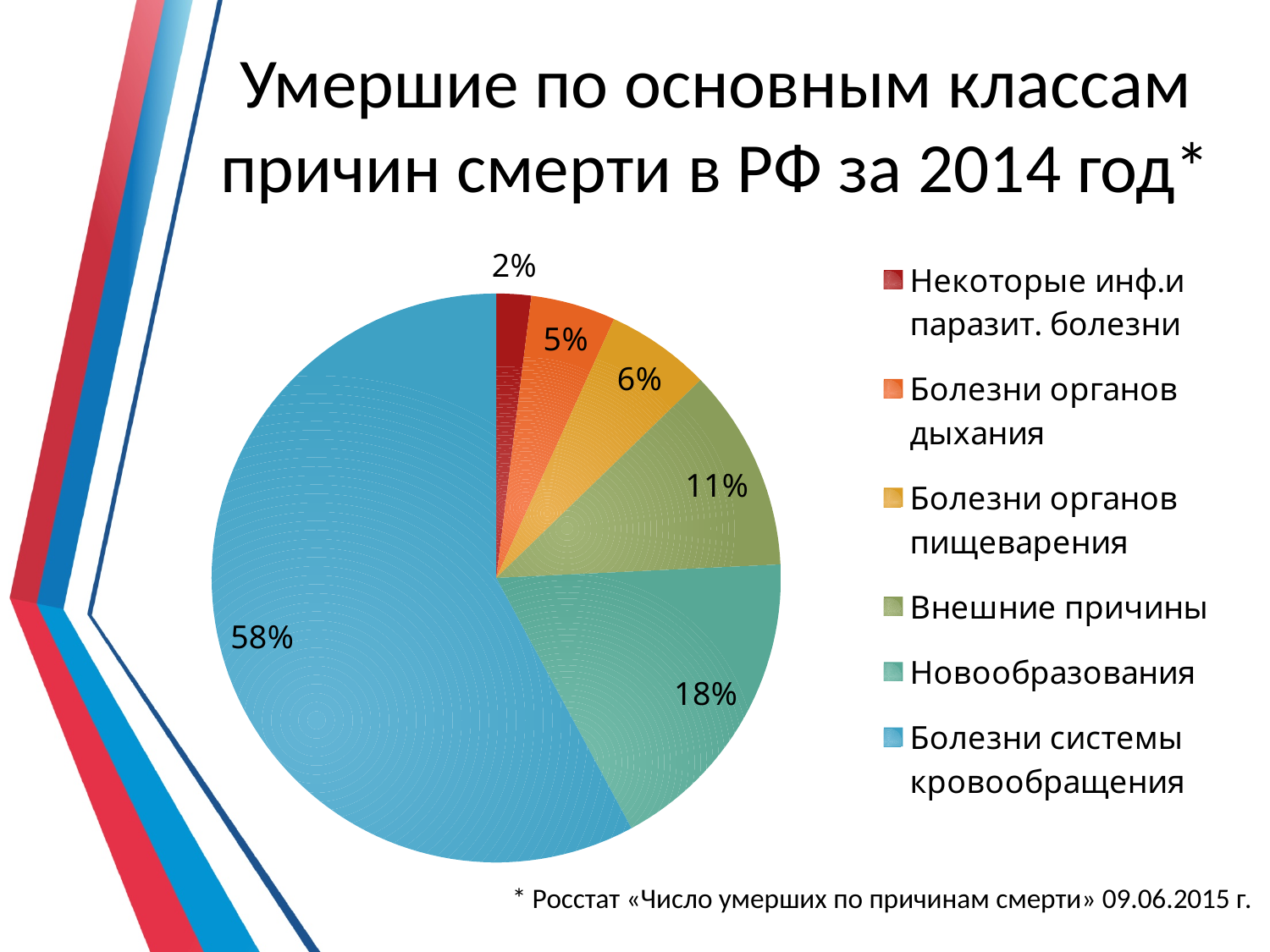
How many categories does the pie chart show? 6 What share of the pie is labelled for Болезни органов дыхания? 5% What share of the pie is labelled for Внешние причины? 11% Which category has the smallest slice of the pie? Некоторые инф.и паразит. болезни What share of the pie is labelled for Новообразования? 18% What is the title of the chart on the slide? Умершие по основным классам причин смерти в РФ за 2014 год What kind of chart is shown on the slide? pie chart What is the difference in percentage points between Новообразования and Внешние причины? 7 Which is larger: the slice for Болезни органов дыхания or the slice for Болезни органов пищеварения? Болезни органов пищеварения Which category has the largest slice of the pie? Болезни системы кровообращения